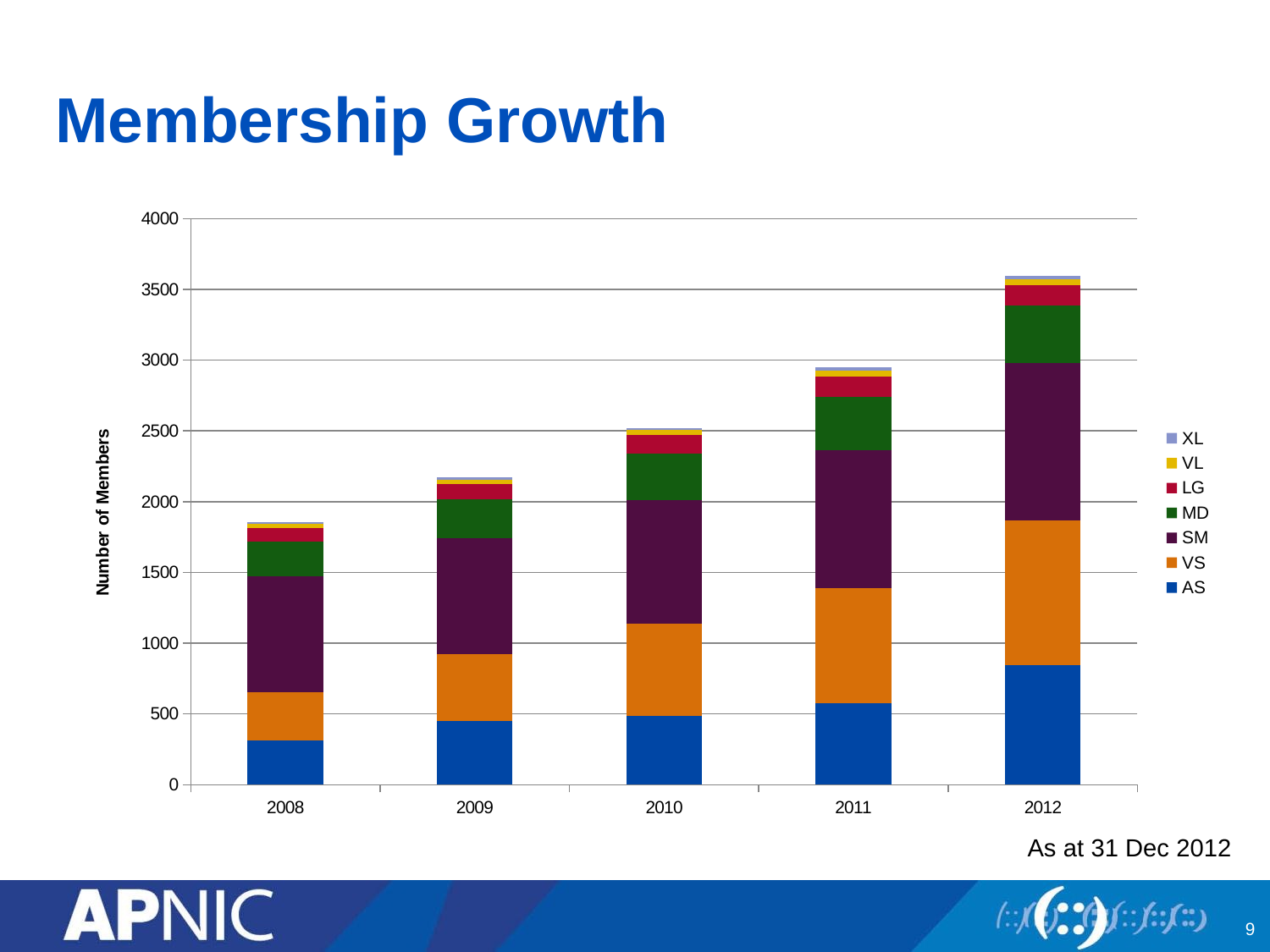
Is the total number of members in 2008 greater or less than 2000? less Is the total number of members in 2012 greater or less than 3000? greater Which year has the highest total number of members? 2012 Is the AS segment for 2012 greater or less than 500? greater What kind of chart is shown on the slide? stacked bar chart Do the total membership values rise or fall from 2008 to 2012? rise Which year has a larger total number of members, 2009 or 2010? 2010 How many years are shown on the x axis of the chart? 5 Which year has the lowest total number of members? 2008 How many series does the chart's legend list? 7 What is the title of the slide containing the chart? Membership Growth What is the label on the chart's y axis? Number of Members